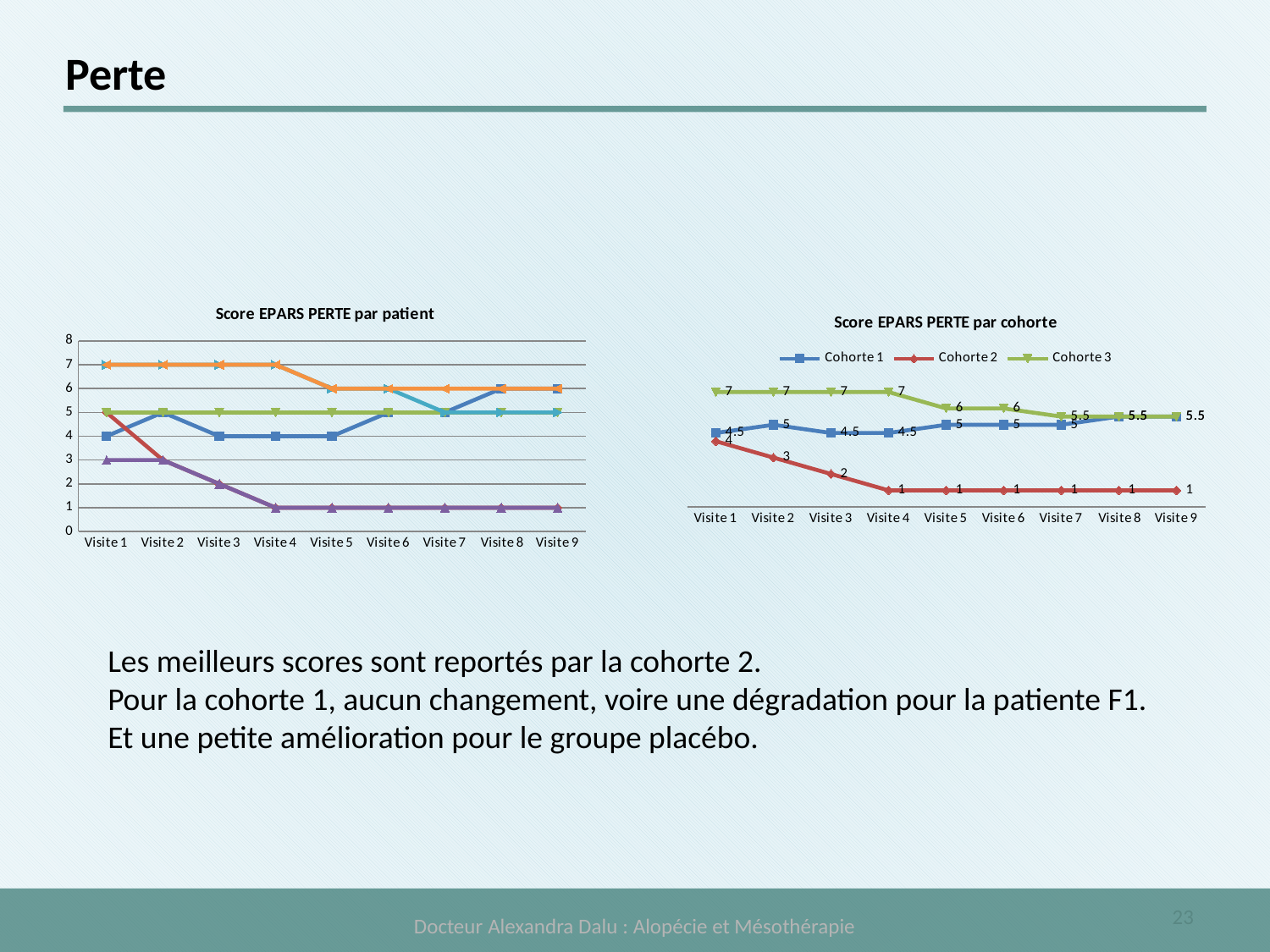
In the 'Score EPARS PERTE par cohorte' chart, which is larger at Visite 2: Cohorte 1 or Cohorte 3? Cohorte 3 In the 'Score EPARS PERTE par cohorte' chart, does the value for Cohorte 2 rise or fall from Visite 1 to Visite 9? Fall What is the title of the chart on the left of the slide? Score EPARS PERTE par patient How many series does the legend of the 'Score EPARS PERTE par cohorte' chart list? 3 In the 'Score EPARS PERTE par cohorte' chart, which cohort has the lowest value at Visite 5? Cohorte 2 In the 'Score EPARS PERTE par cohorte' chart, what is the difference between the Cohorte 3 value at Visite 1 and at Visite 9? 1.5 In the 'Score EPARS PERTE par cohorte' chart, what is the value for Cohorte 1 at Visite 9? 5.5 In the 'Score EPARS PERTE par cohorte' chart, what is the value for Cohorte 3 at Visite 1? 7 What kind of chart is the 'Score EPARS PERTE par patient' chart? Line chart How many visits are shown on the x axis of the 'Score EPARS PERTE par cohorte' chart? 9 What kind of chart is the 'Score EPARS PERTE par cohorte' chart? Line chart In the 'Score EPARS PERTE par cohorte' chart, what is the value for Cohorte 2 at Visite 3? 2